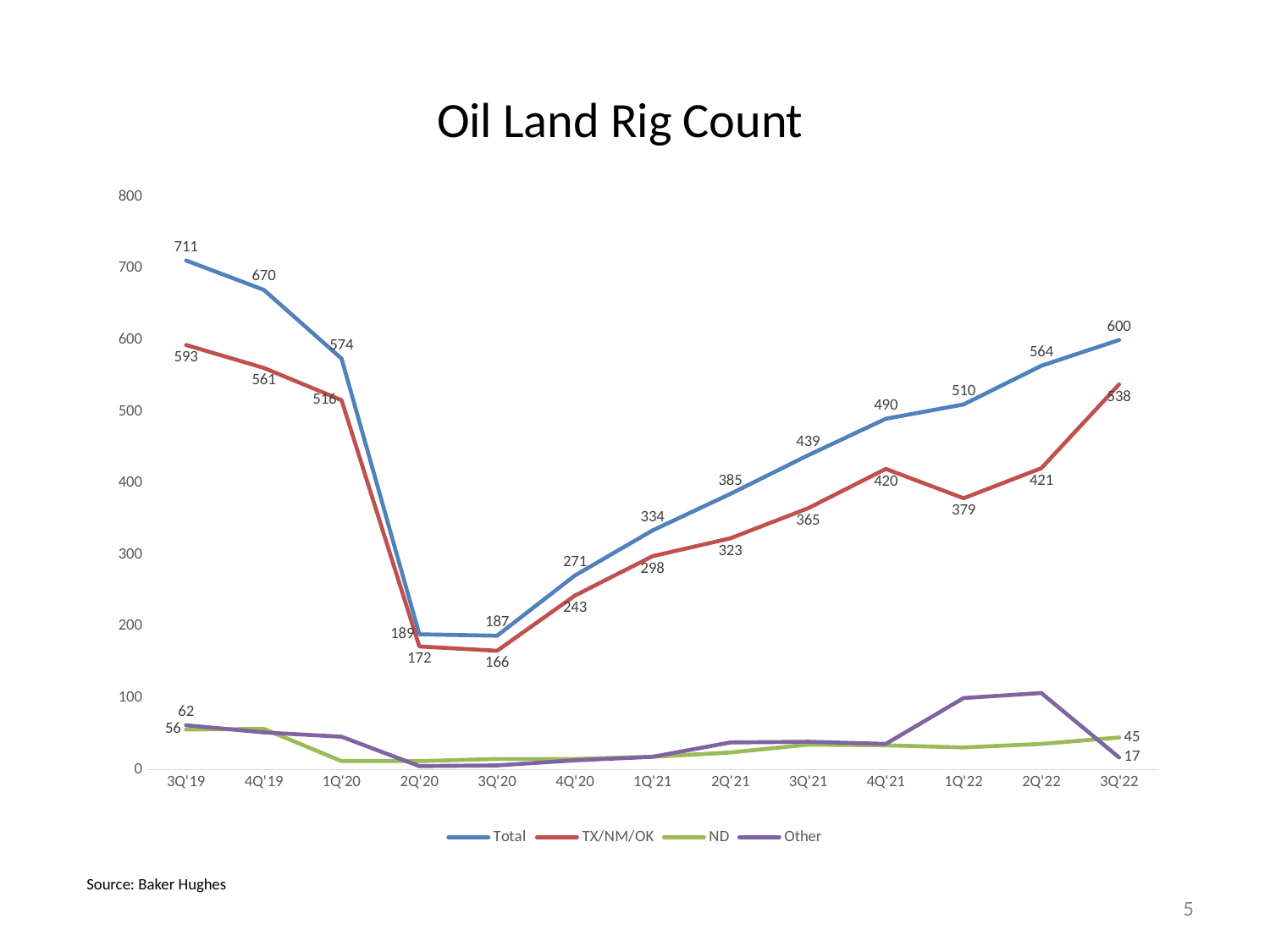
What kind of chart is shown on the slide? line chart What is the TX/NM/OK rig count in 3Q'20? 166 How many quarters are plotted along the x axis? 13 Which is larger for TX/NM/OK: the value in 4Q'21 or the value in 1Q'22? 4Q'21 How many series does the legend list? 4 In which quarter is the Total rig count highest? 3Q'19 What is the ND rig count in 3Q'22? 45 What is the difference between the Total and the TX/NM/OK rig counts in 3Q'22? 62 What is the Total oil land rig count in 3Q'19? 711 In which quarter is the Total rig count lowest? 3Q'20 Is the value for ND in 1Q'20 greater or less than 100? less What is the Total rig count in 1Q'22? 510